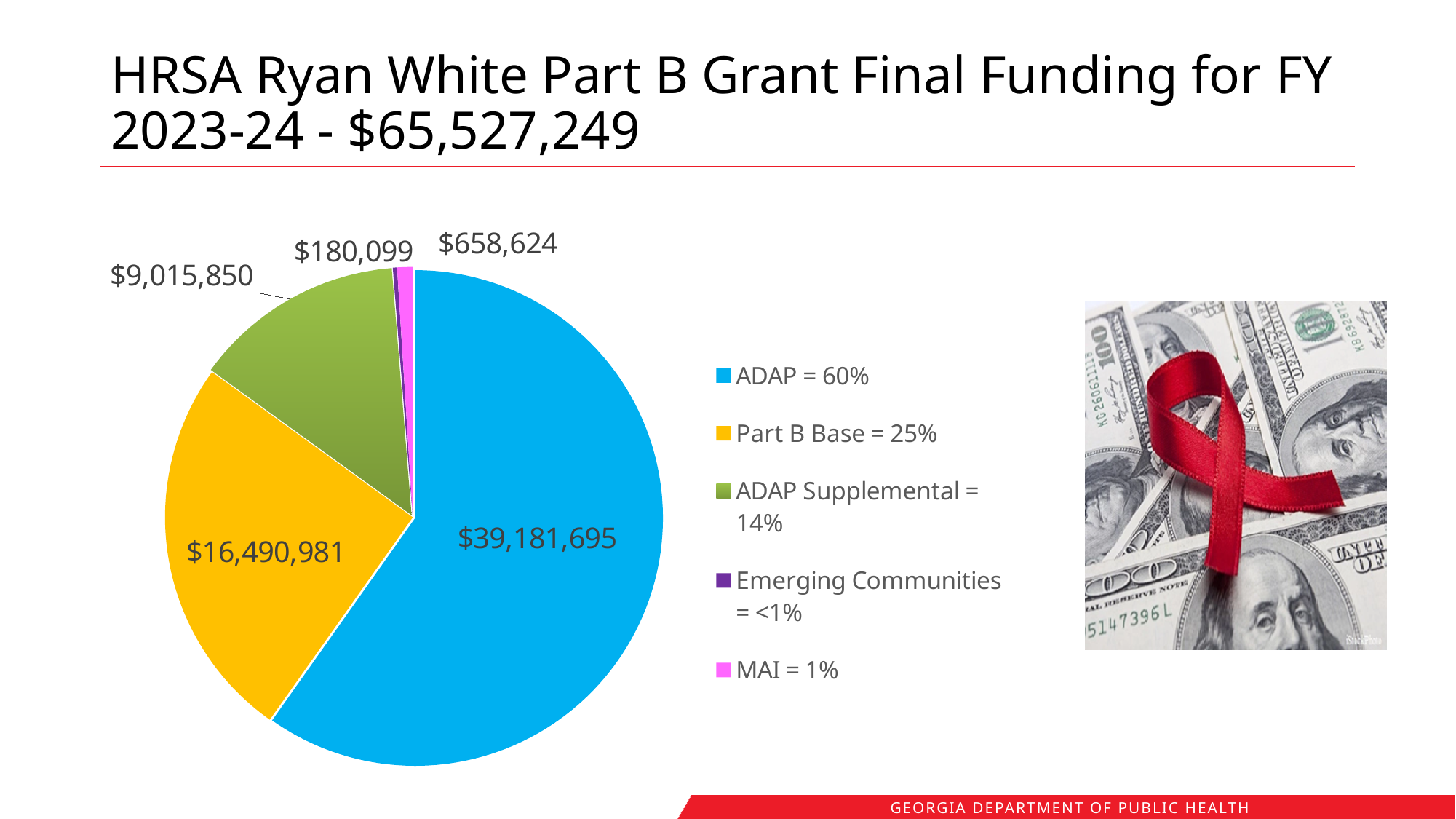
What share of the total funding does ADAP Supplemental represent, according to the legend? 14% What is the funding amount for MAI? $658,624 What is the funding amount for Emerging Communities? $180,099 What type of chart is shown on the slide? Pie chart What is the funding amount for ADAP? $39,181,695 Which category receives the smallest share of the funding? Emerging Communities Which is larger, the funding for MAI or for Emerging Communities? MAI Which category receives the largest share of the funding? ADAP What is the funding amount for ADAP Supplemental? $9,015,850 What is the difference between the ADAP and Part B Base funding amounts? $22,690,714 What is the difference between the Part B Base and ADAP Supplemental funding amounts? $7,475,131 What is the funding amount for Part B Base? $16,490,981